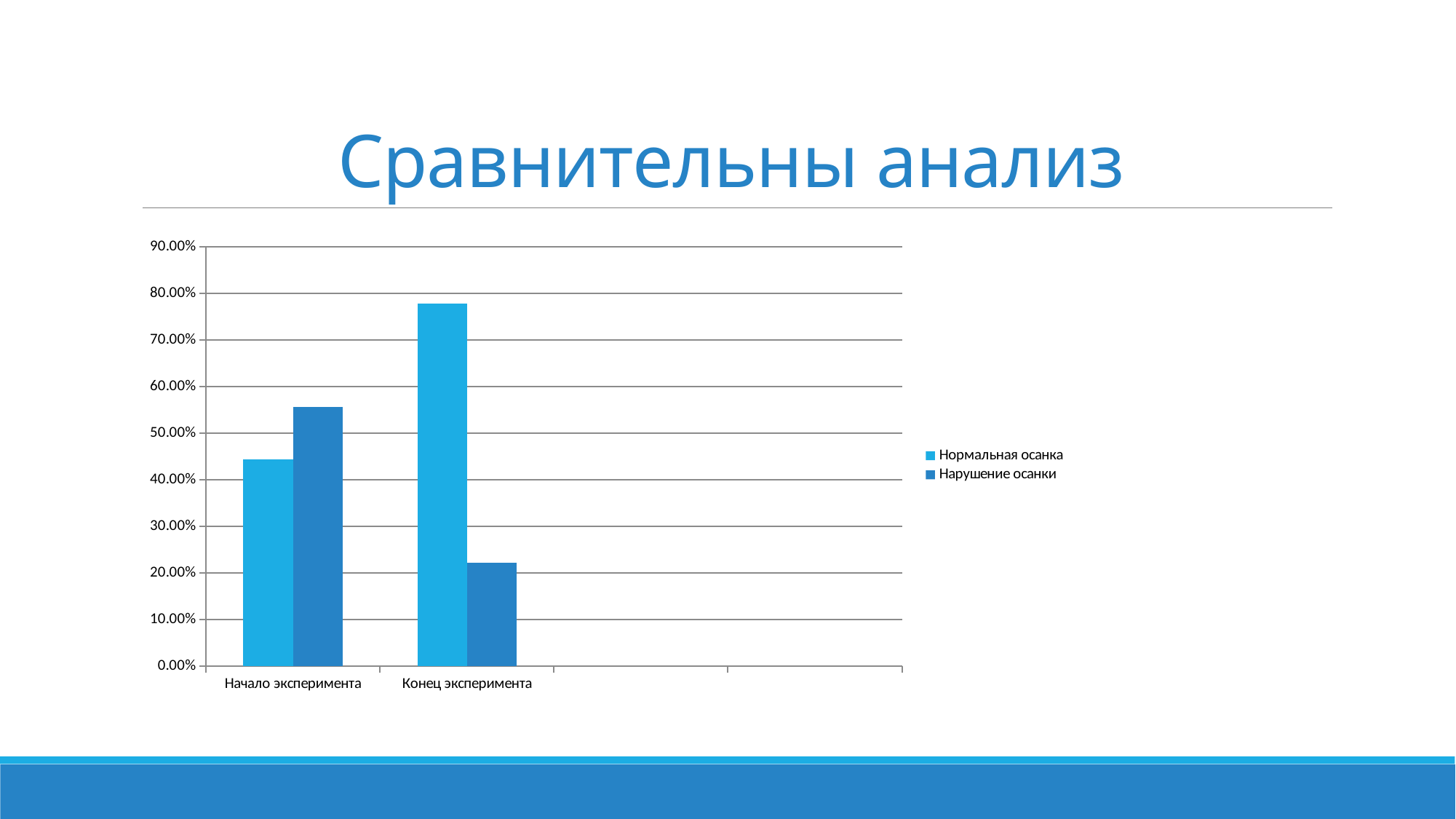
Is the value for Нарушение осанки at Начало эксперимента greater or less than 50.00%? greater Is the value for Нормальная осанка at Начало эксперимента greater or less than 50.00%? less At Начало эксперимента, which series has the larger value, Нормальная осанка or Нарушение осанки? Нарушение осанки Does the value for Нарушение осанки rise or fall from Начало эксперимента to Конец эксперимента? fall What is the title of the slide above the chart? Сравнительны анализ How many categories are shown on the x axis? 2 Is the value for Нормальная осанка at Конец эксперимента greater or less than 70.00%? greater Which series is shown in the darker blue colour? Нарушение осанки Which category has the highest value for Нормальная осанка? Конец эксперимента What kind of chart is shown on the slide? bar chart How many series does the legend list? 2